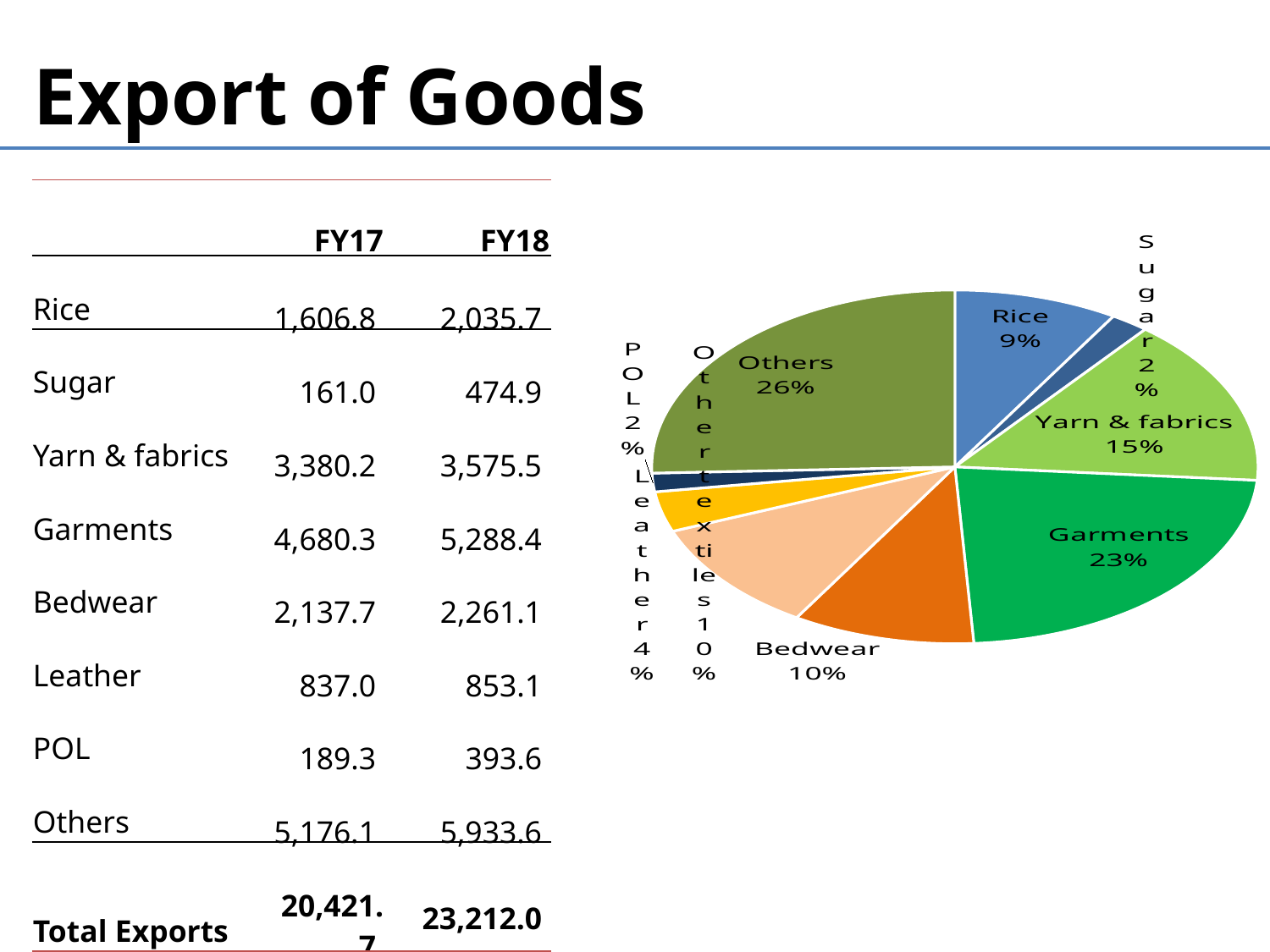
What kind of chart is shown on the slide? pie chart What share of the pie chart does Leather account for? 4% What share of the pie chart does Garments account for? 23% How many percentage points larger is the Others slice than the Garments slice in the pie chart? 3 What share of the pie chart does Yarn & fabrics account for? 15% Which category has the largest slice in the pie chart? Others How many slices does the pie chart have? 9 What is the title of the slide containing the pie chart? Export of Goods Which slice is larger in the pie chart, Garments or Yarn & fabrics? Garments